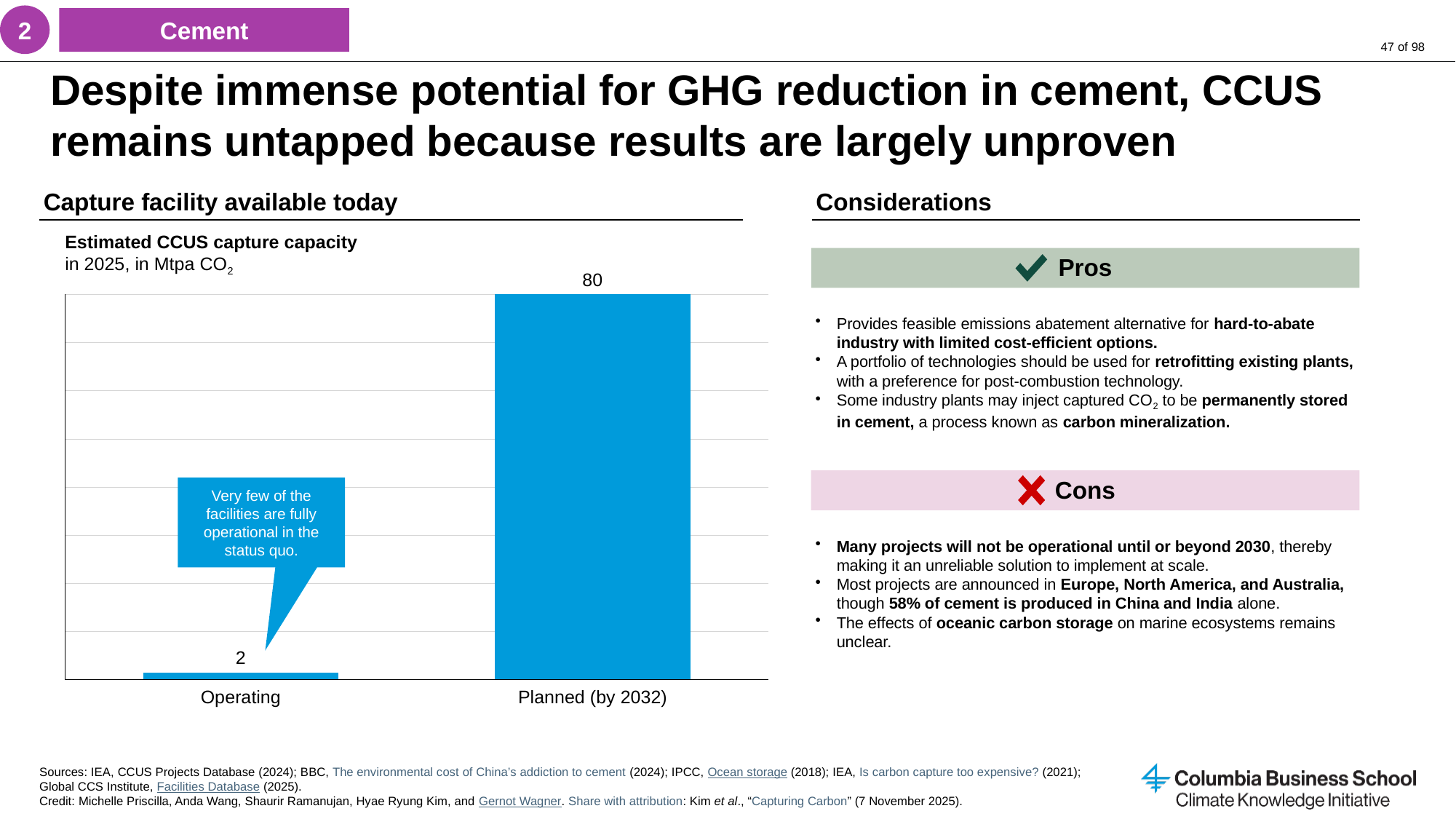
Which category has the highest estimated CCUS capture capacity? Planned (by 2032) What kind of chart is shown on the slide? Bar chart What unit is the estimated CCUS capture capacity measured in? Mtpa CO2 Which is larger, the Operating capacity or the Planned (by 2032) capacity? Planned (by 2032) What is the difference between the Planned (by 2032) and Operating capture capacities? 78 Do the values rise or fall from Operating to Planned (by 2032)? Rise What is the total of the Operating and Planned (by 2032) capture capacities? 82 Which category has the lowest estimated CCUS capture capacity? Operating What is the estimated CCUS capture capacity for the Operating category? 2 How many categories are shown in the chart? 2 What does the callout on the Operating bar say? Very few of the facilities are fully operational in the status quo. What is the estimated CCUS capture capacity for the Planned (by 2032) category? 80